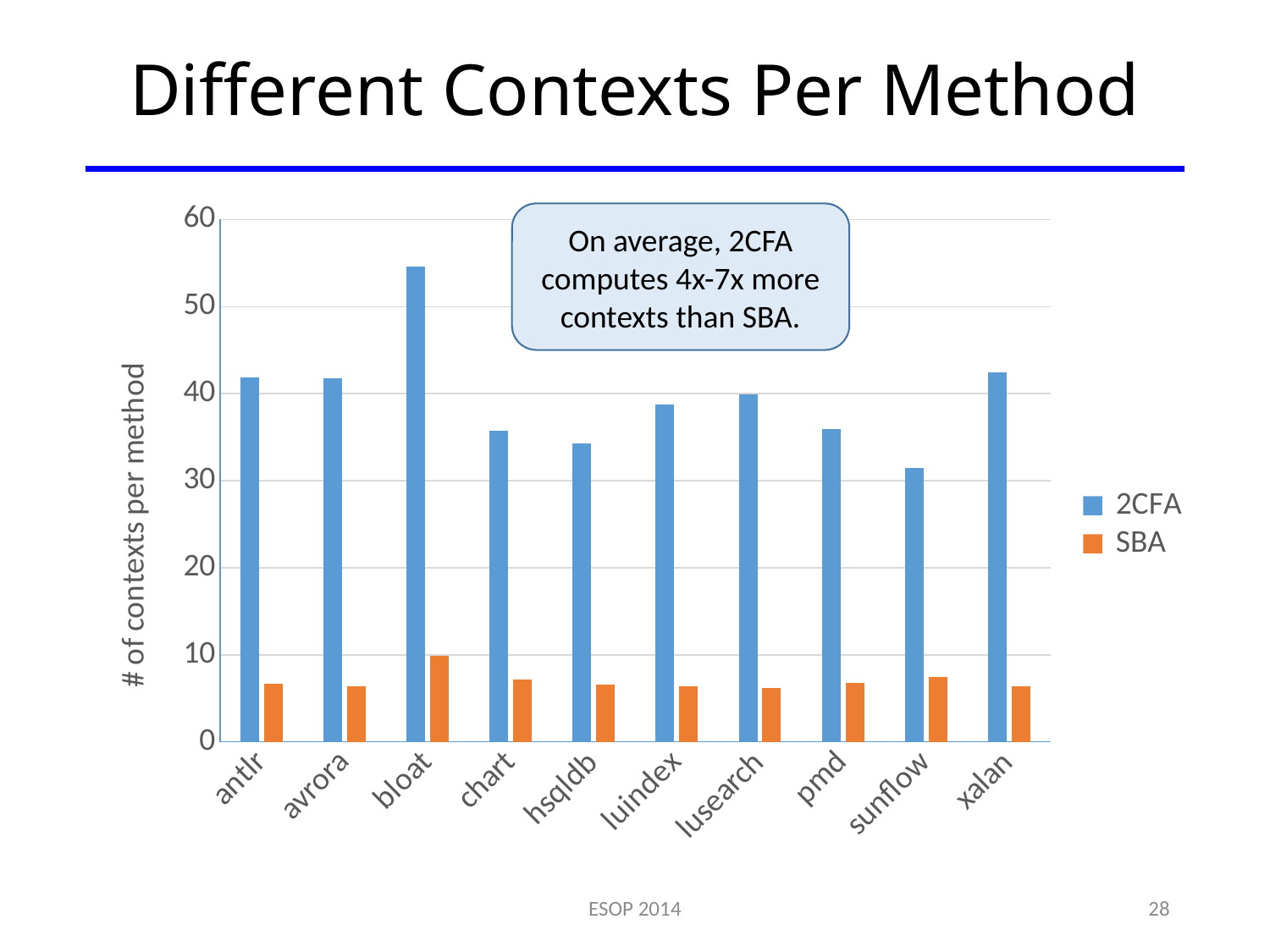
Is the 2CFA value for bloat greater or less than 50? greater How many series does the legend list? 2 Which category has the lowest 2CFA value? sunflow Which category has the highest 2CFA value? bloat Which category has the highest SBA value? bloat Is the SBA value for chart greater or less than 10? less For antlr, which series has the larger value, 2CFA or SBA? 2CFA How many benchmark categories are shown on the x axis? 10 Which is larger, the 2CFA value for bloat or the 2CFA value for chart? bloat Is the 2CFA value for hsqldb greater or less than 40? less What type of chart is shown on the slide? bar chart What is the label of the y axis? # of contexts per method